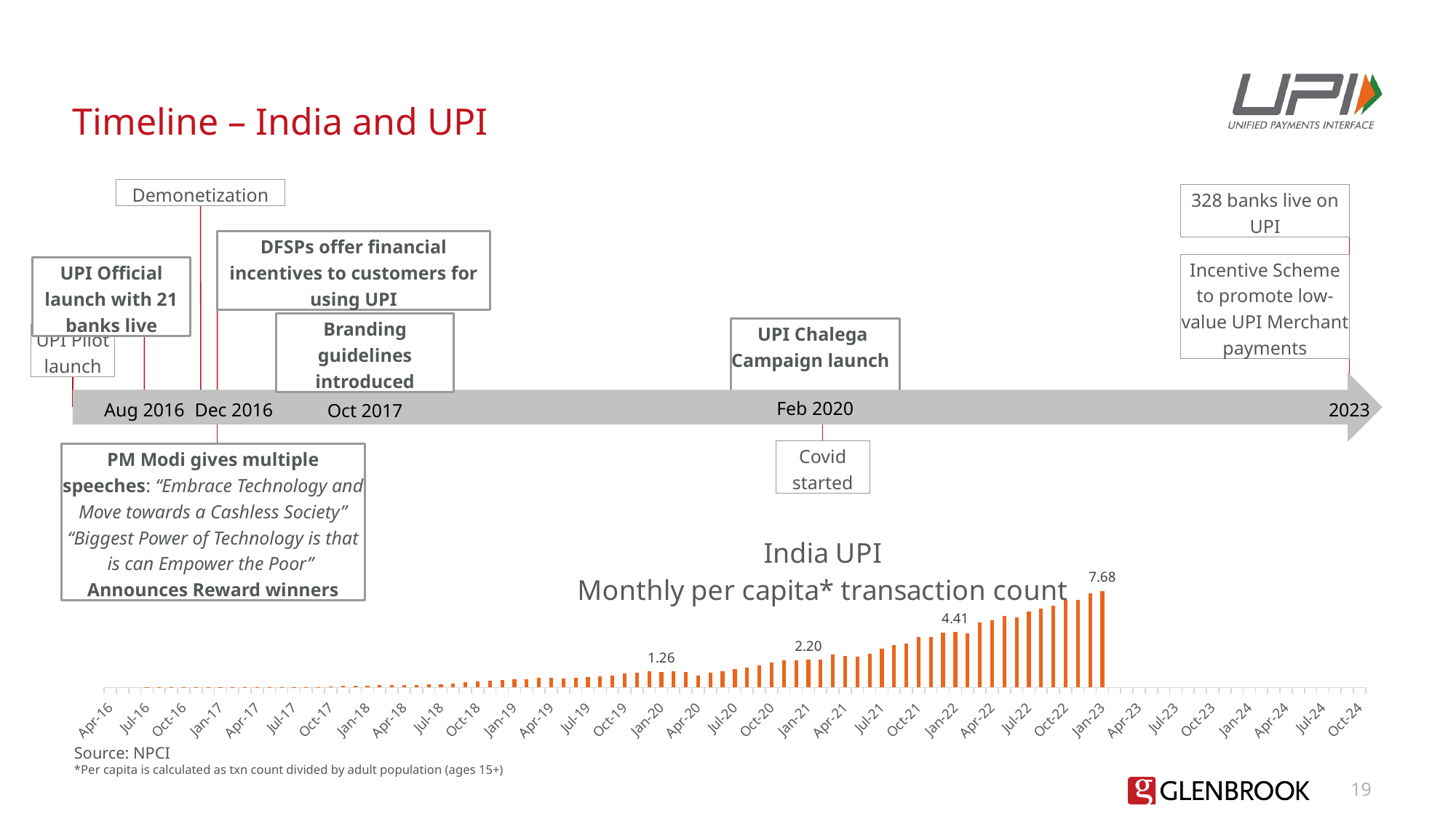
What is the title of the chart on the slide? India UPI Monthly per capita* transaction count What is the difference between the labeled values 2.20 and 1.26 on the India UPI chart? 0.94 What is the difference between the labeled values 4.41 and 2.20 on the India UPI chart? 2.21 What is the highest value labeled on the India UPI chart? 7.68 What source is cited for the India UPI chart? NPCI Which is larger on the India UPI chart: the bar labeled 4.41 or the bar labeled 2.20? 4.41 How many data labels are printed on the India UPI chart? 4 What is the difference between the labeled values 7.68 and 4.41 on the India UPI chart? 3.27 What is the lowest value labeled on the India UPI chart? 1.26 What is the second data label from the left on the India UPI chart? 2.20 What kind of chart is shown at the bottom of the slide? bar chart Do the values on the India UPI chart rise or fall from Apr-16 to Jan-23? rise